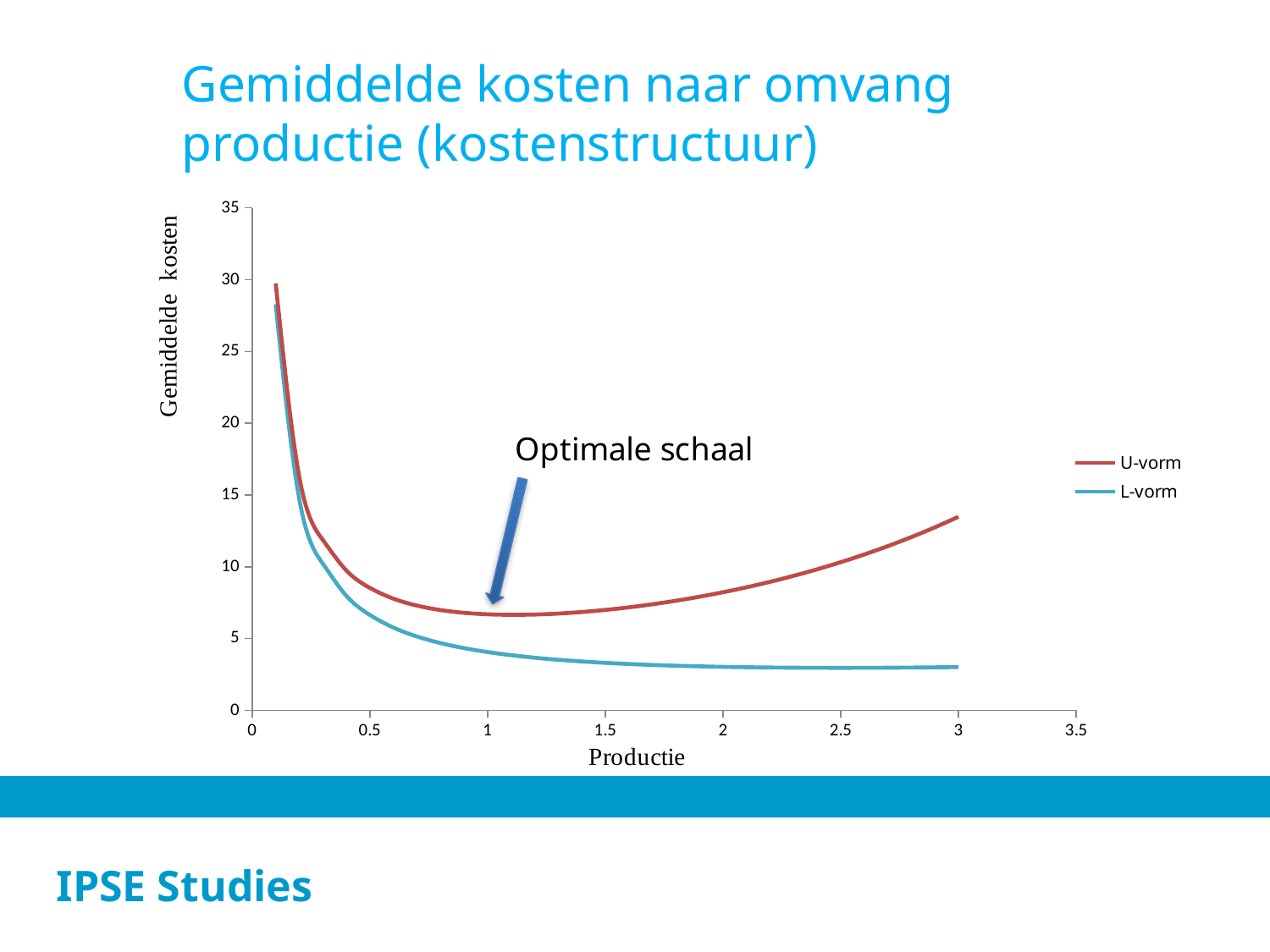
At Productie 0.5, which line has the higher value, U-vorm or L-vorm? U-vorm What kind of chart is shown on the slide? line chart Does the L-vorm line rise or fall as Productie increases? fall Is the value of the L-vorm line at Productie 3 greater or less than 5? less Is the value of the L-vorm line at Productie 2 greater or less than 5? less How many series does the legend list? 2 What are the two series named in the legend? U-vorm and L-vorm Is the value of the U-vorm line at Productie 3 greater or less than 10? greater What is the title of the chart? Gemiddelde kosten naar omvang productie (kostenstructuur) At Productie 3, which line has the higher value, U-vorm or L-vorm? U-vorm Does the U-vorm line rise or fall between Productie 1.5 and Productie 3? rise